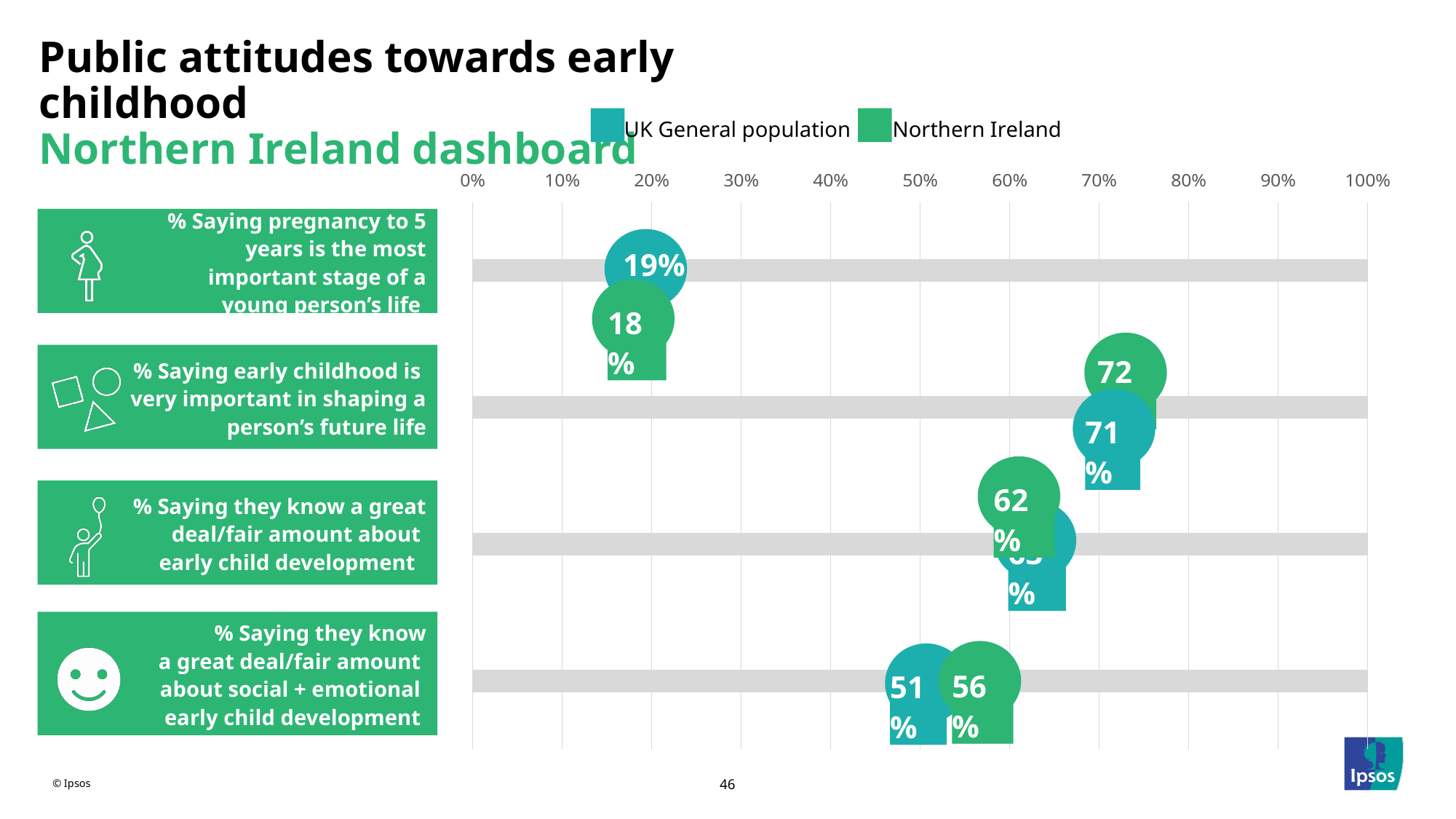
What percentage of the UK General population say early childhood is very important in shaping a person's future life? 71% What percentage of Northern Ireland respondents say they know a great deal/fair amount about social + emotional early child development? 56% What is the difference in percentage points between Northern Ireland and the UK General population for knowing a great deal/fair amount about social + emotional early child development? 5 percentage points What percentage of Northern Ireland respondents say early childhood is very important in shaping a person's future life? 72% What percentage of Northern Ireland respondents say pregnancy to 5 years is the most important stage of a young person's life? 18% What percentage of the UK General population say they know a great deal/fair amount about social + emotional early child development? 51% Which colour represents Northern Ireland in the legend? Green Which statement has the highest value for Northern Ireland? % Saying early childhood is very important in shaping a person's future life What percentage of the UK General population say pregnancy to 5 years is the most important stage of a young person's life? 19% Which statement has the lowest value for Northern Ireland? % Saying pregnancy to 5 years is the most important stage of a young person's life How many series does the legend list? 2 For knowing a great deal/fair amount about social + emotional early child development, which is larger: the UK General population value or the Northern Ireland value? Northern Ireland